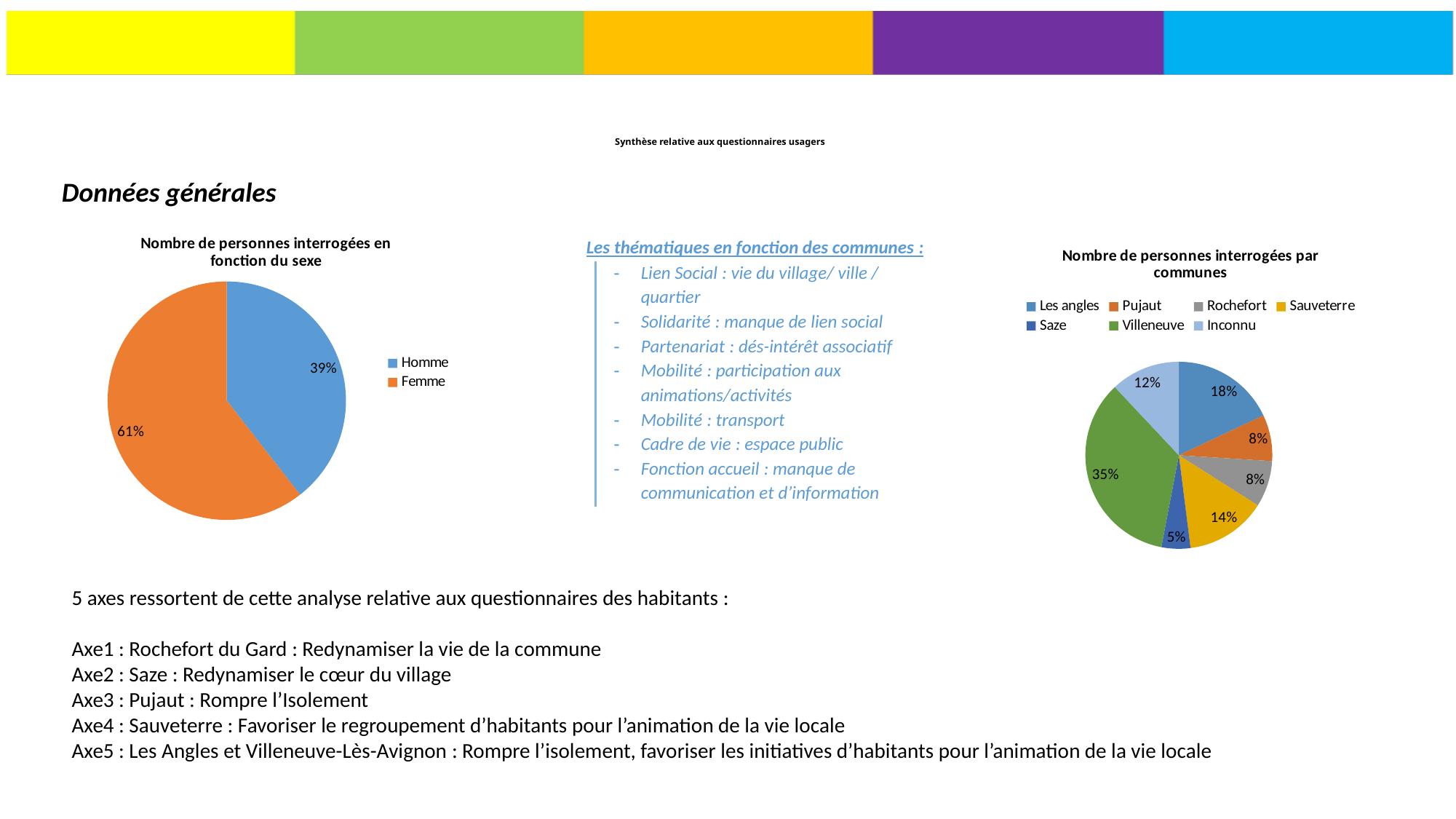
In the chart 'Nombre de personnes interrogées par communes', what share is Villeneuve? 35% In the chart 'Nombre de personnes interrogées par communes', which commune has the smallest share? Saze In the chart 'Nombre de personnes interrogées par communes', what share is Les angles? 18% In the chart 'Nombre de personnes interrogées en fonction du sexe', which category has the larger share? Femme In the chart 'Nombre de personnes interrogées par communes', which is larger, Sauveterre or Inconnu? Sauveterre In the chart 'Nombre de personnes interrogées en fonction du sexe', what share is Homme? 39% In the chart 'Nombre de personnes interrogées par communes', how many categories does the legend list? 7 What kind of chart is 'Nombre de personnes interrogées en fonction du sexe'? Pie chart In the chart 'Nombre de personnes interrogées en fonction du sexe', what is the difference between the Femme and Homme shares? 22% In the chart 'Nombre de personnes interrogées par communes', which commune has the largest share? Villeneuve